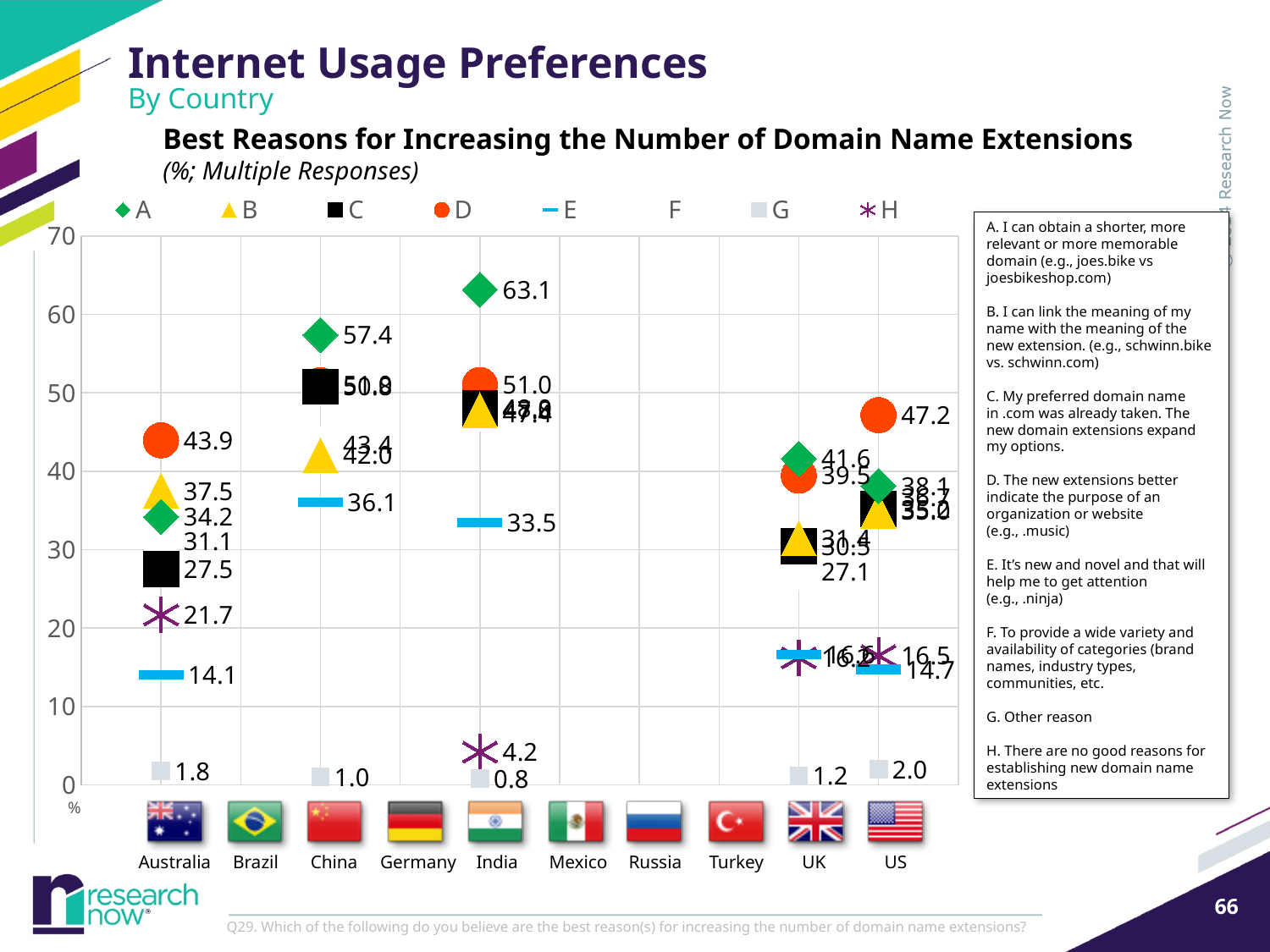
What is the value for series A for China? 57.4 What is the value for series E for Australia? 14.1 What is the value for series H for India? 4.2 What is the value for series A for India? 63.1 What is the difference between the series A values for India and China? 5.7 What is the value for series D (the new extensions better indicate the purpose of an organization or website) for Australia? 43.9 Which is larger for Australia: the value for series D or the value for series B? Series D How many series does the legend list? 8 What is the subtitle shown under the chart title? (%; Multiple Responses) How many countries are shown on the x axis? 10 What is the value for series D for the US? 47.2 Which country has the highest plotted value on the chart? India